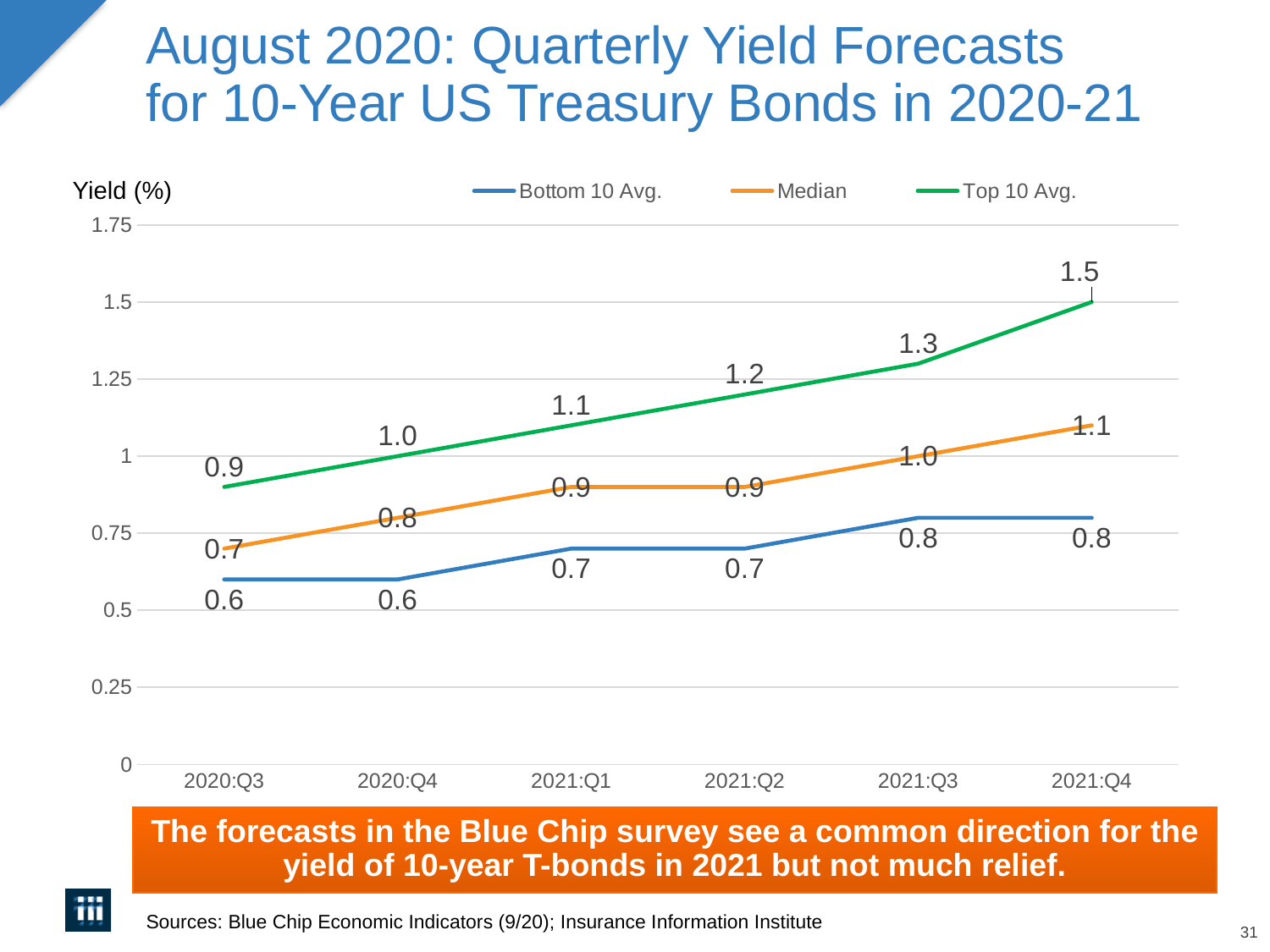
What colour is the line for the Median series? Orange How many quarters are shown on the x axis? 6 What is the difference between the Top 10 Avg. and Bottom 10 Avg. forecasts for 2021:Q4? 0.7 What type of chart is shown on the slide? Line chart Which is larger in 2021:Q3, the Median forecast or the Bottom 10 Avg. forecast? Median Does the Top 10 Avg. forecast rise or fall from 2020:Q3 to 2021:Q4? Rise In which quarter is the Top 10 Avg. forecast highest? 2021:Q4 How many series does the legend list? 3 What is the Median forecast yield for 2021:Q1? 0.9 What is the difference between the Median forecasts for 2021:Q4 and 2020:Q3? 0.4 What is the Bottom 10 Avg. forecast yield for 2020:Q3? 0.6 What is the Top 10 Avg. forecast yield for 2021:Q4? 1.5